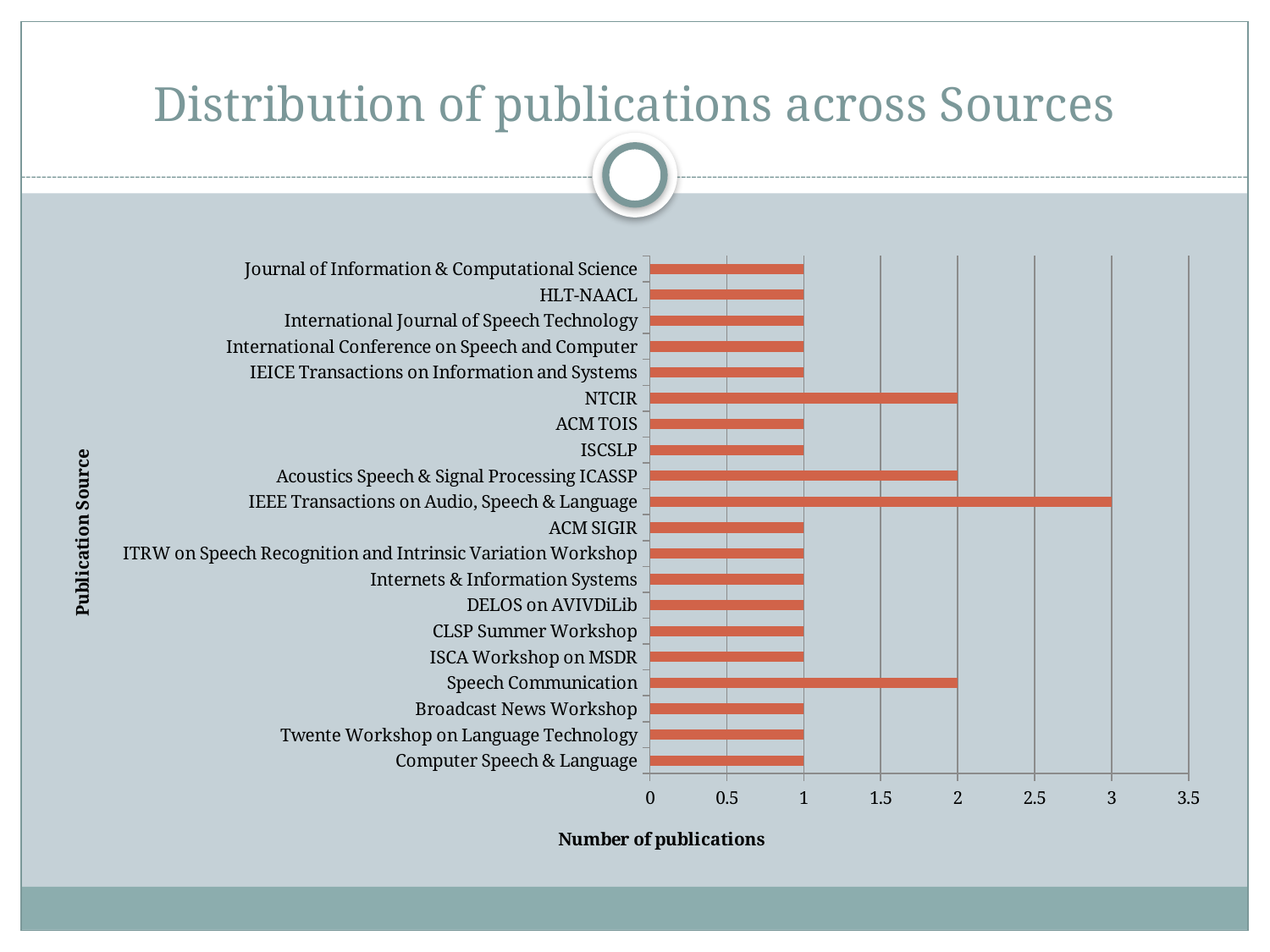
What type of chart is shown on the slide? Bar chart How many publications does Speech Communication have? 2 Which has more publications, Speech Communication or Computer Speech & Language? Speech Communication What is the title of the chart? Distribution of publications across Sources How many publications does NTCIR have? 2 How many publications does ACM SIGIR have? 1 What is the difference in number of publications between IEEE Transactions on Audio, Speech & Language and NTCIR? 1 How many publication sources are shown in the chart? 20 What is the label of the horizontal axis? Number of publications How many publications does IEEE Transactions on Audio, Speech & Language have? 3 Which publication source has the highest number of publications? IEEE Transactions on Audio, Speech & Language How many publications does Acoustics Speech & Signal Processing ICASSP have? 2